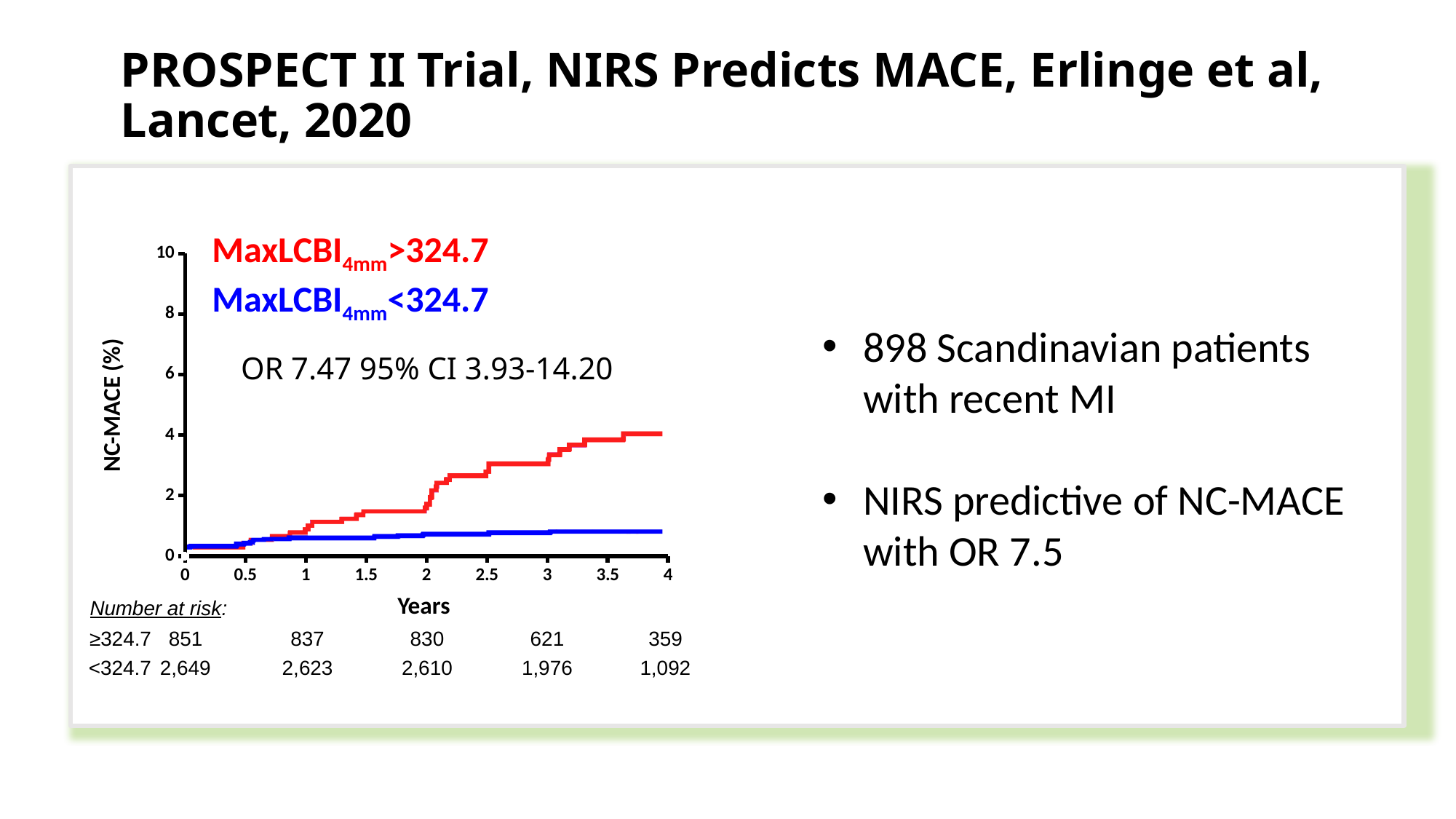
Is the NC-MACE (%) value for the MaxLCBI4mm <324.7 series at 4 years greater or less than 2? less What kind of chart is shown on the slide? line chart What is the number at risk for the ≥324.7 group at year 0? 851 What is the difference in number at risk at year 0 between the <324.7 group and the ≥324.7 group? 1,798 What is the label of the y axis of the chart? NC-MACE (%) Does the NC-MACE (%) for the MaxLCBI4mm >324.7 series rise or fall over the years? rise What is the number at risk for the ≥324.7 group at year 3? 621 Which series has the higher NC-MACE (%) at 4 years, MaxLCBI4mm >324.7 or MaxLCBI4mm <324.7? MaxLCBI4mm >324.7 What colour is the line for the MaxLCBI4mm <324.7 series? blue How many series are plotted on the chart? 2 What is the number at risk for the <324.7 group at year 4? 1,092 Is the NC-MACE (%) value for the MaxLCBI4mm >324.7 series at 4 years greater or less than 2? greater